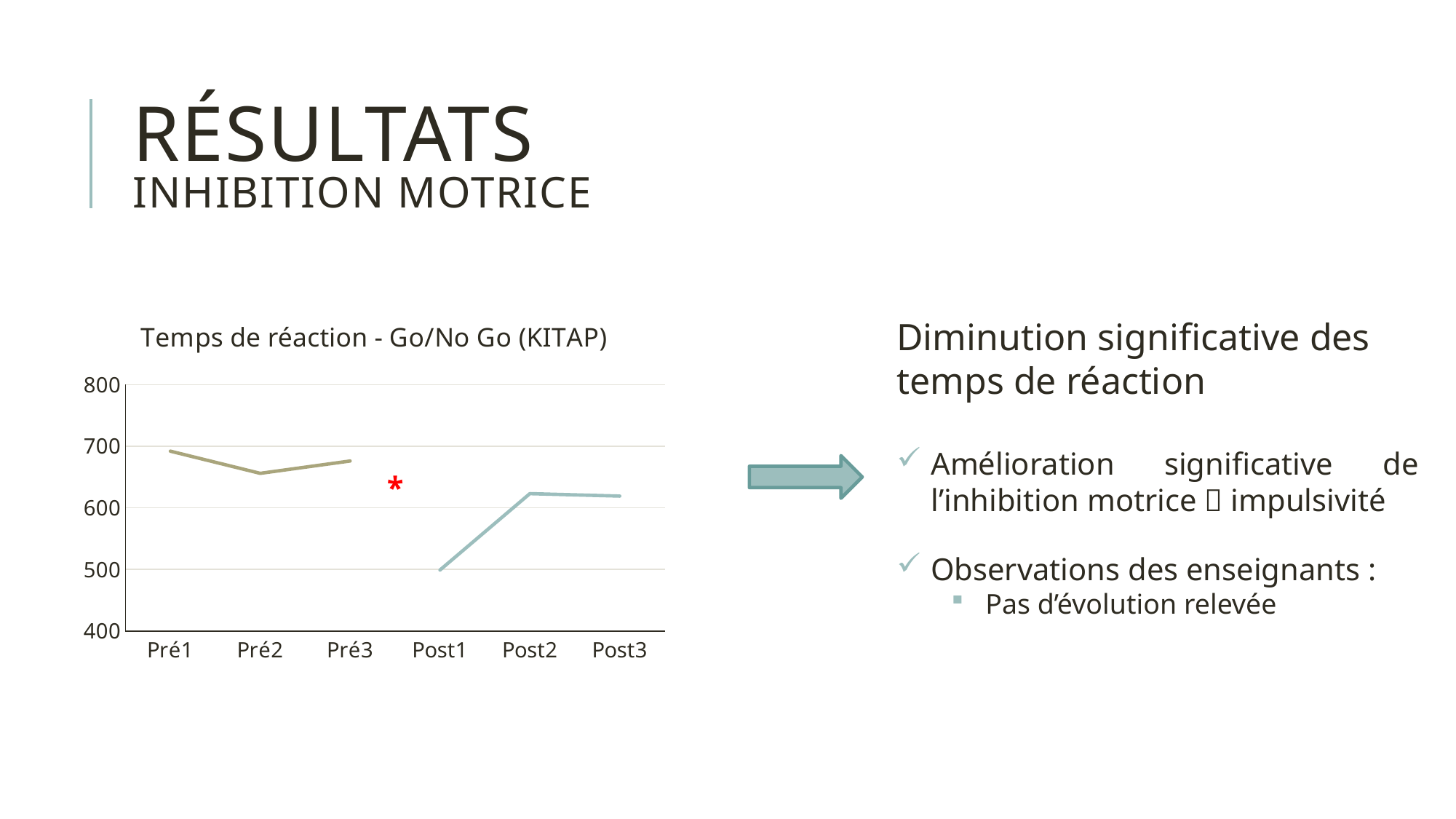
Is the value for Pré1 greater or less than 600? greater How many categories are shown on the x axis of the chart? 6 Does the value rise or fall from Post1 to Post2? rise Which category has the lowest value in the chart? Post1 Does the value rise or fall from Pré1 to Pré2? fall Is the value for Pré2 greater or less than 700? less Which is larger, the value for Pré3 or the value for Post3? Pré3 What kind of chart is shown on the slide? line chart What is the title of the chart? Temps de réaction - Go/No Go (KITAP) Is the value for Post2 greater or less than 700? less Which category has the highest value in the chart? Pré1